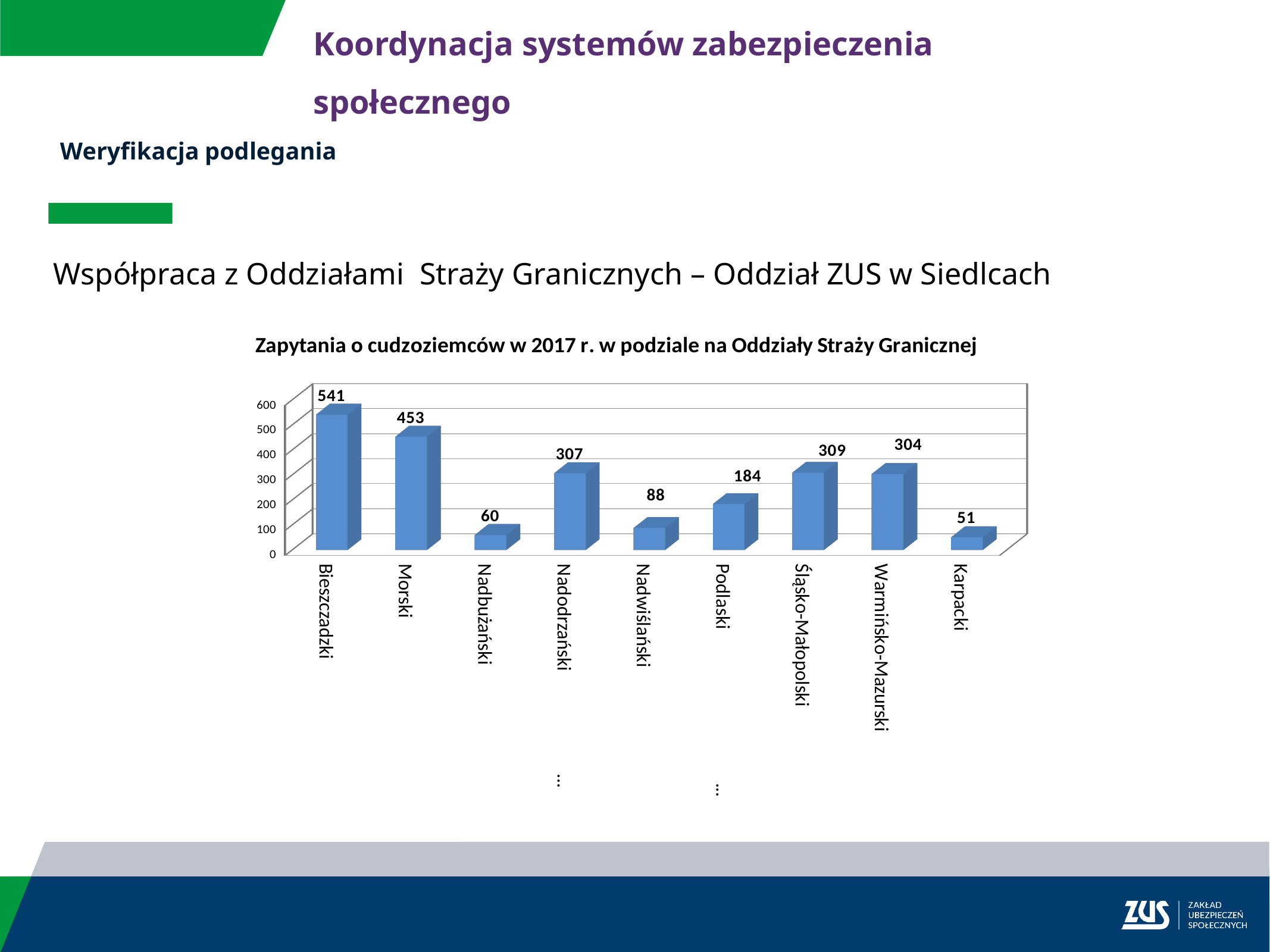
What is the value for Nadodrzański? 307 Which is larger, the value for Morski or the value for Nadodrzański? Morski What is the difference between the values for Bieszczadzki and Morski? 88 What is the title of the chart? Zapytania o cudzoziemców w 2017 r. w podziale na Oddziały Straży Granicznej What is the value for Karpacki? 51 Which is larger, the value for Nadbużański or the value for Nadwiślański? Nadwiślański How many categories are shown on the x axis? 9 What is the difference between the values for Podlaski and Nadwiślański? 96 Which category has the lowest value? Karpacki What kind of chart is shown on the slide? Bar chart Which category has the highest value? Bieszczadzki What is the value for Bieszczadzki? 541